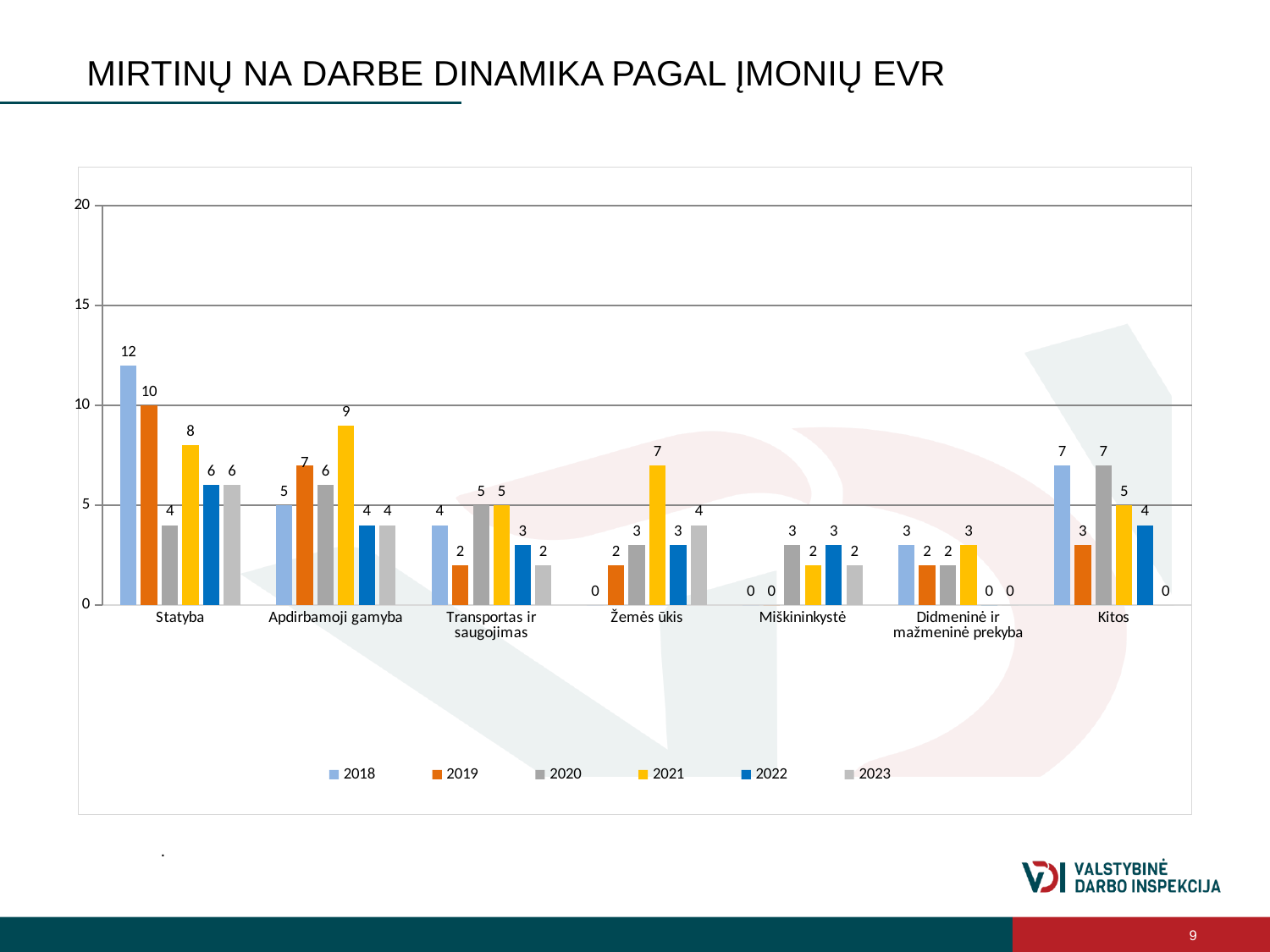
What kind of chart is shown on the slide? bar chart Which category has the lowest value in 2019? Miškininkystė Which category has the highest value in 2018? Statyba What is the value for Statyba in 2018? 12 How many categories are shown on the x axis? 7 Is the value for Statyba in 2018 greater or less than 10? greater How many series does the legend list? 6 What is the value for Apdirbamoji gamyba in 2021? 9 What is the difference between the 2018 and 2019 values for Statyba? 2 What is the value for Žemės ūkis in 2021? 7 Which is larger for Transportas ir saugojimas: the 2018 value or the 2019 value? 2018 What is the value for Kitos in 2023? 0